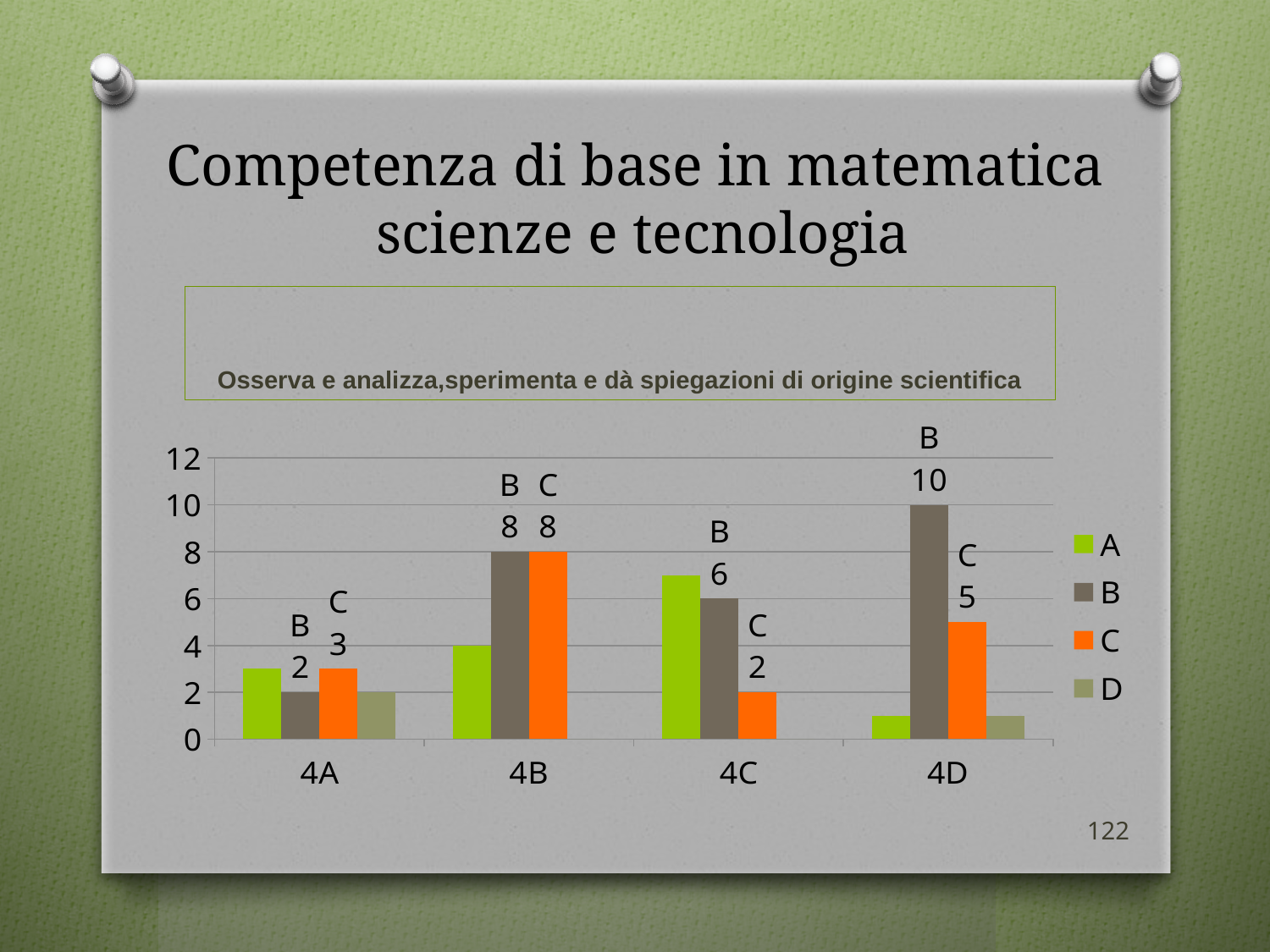
In category 4D, what is the difference between the value of series B and the value of series C? 5 Is the value of series A for category 4C greater or less than 6? greater What is the value of series C for category 4C? 2 What is the value of series C for category 4D? 5 Which category has the lowest value for series C? 4C What kind of chart is shown on the slide? bar chart How many series does the legend list? 4 Which category has the highest value for series B? 4D Which is larger: the value of series B for 4B or the value of series B for 4C? 4B How many categories are shown on the x axis? 4 What is the value of series B for category 4D? 10 What is the value of series B for category 4B? 8